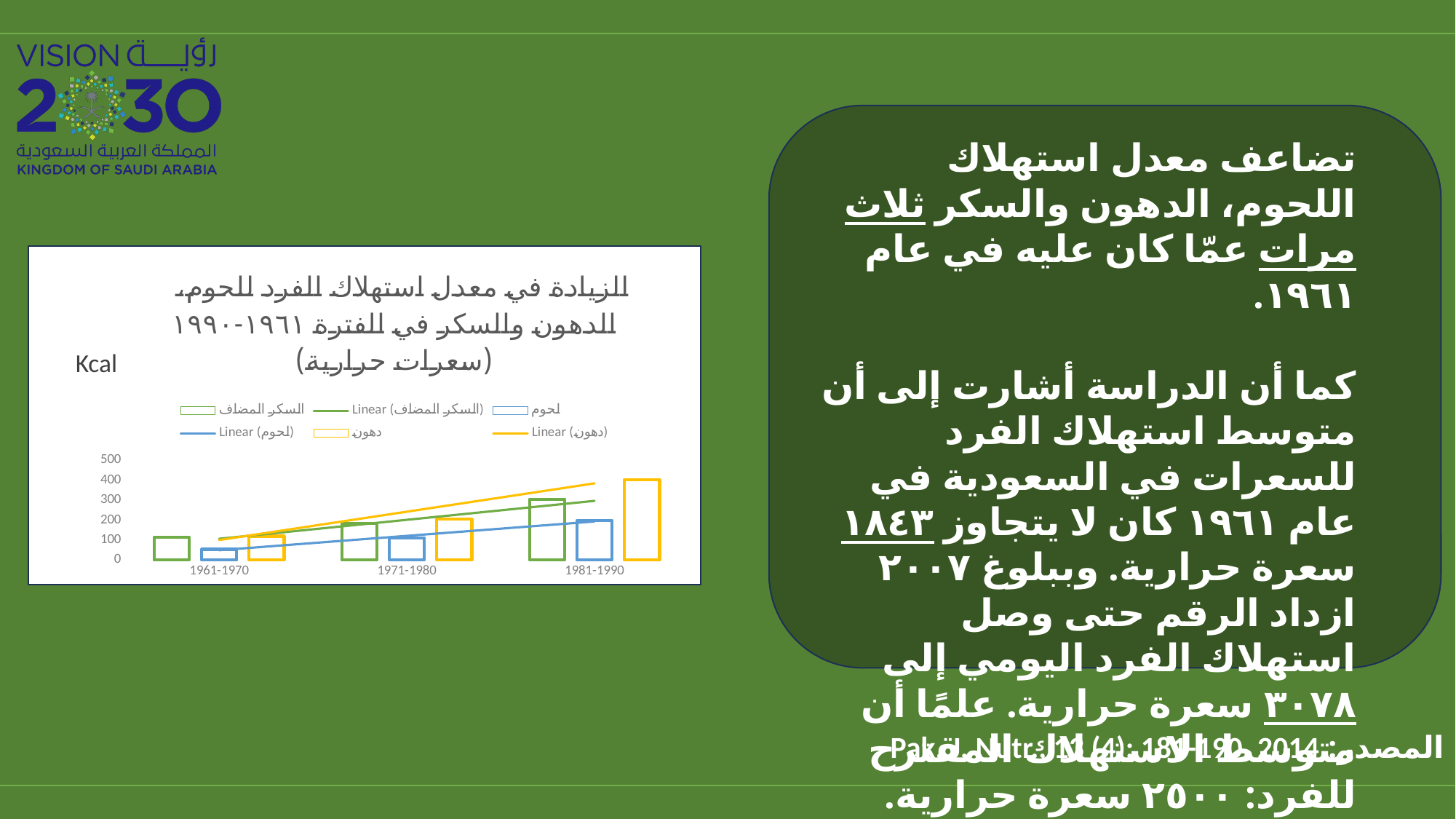
What kind of chart is shown on the slide? bar chart How many time periods are shown on the x axis of the chart? 3 What unit label is shown at the top of the chart's vertical axis? Kcal Is the value for السكر المضاف in 1981-1990 greater or less than 200? greater Is the value for دهون in 1971-1980 greater or less than 300? less In 1981-1990, which is larger: دهون or لحوم? دهون Do the values for دهون rise or fall from 1961-1970 to 1981-1990? rise How many entries does the chart's legend list? 6 In which period is the value for لحوم lowest? 1961-1970 Is the value for دهون in 1981-1990 greater or less than 300? greater In which period is the value for دهون highest? 1981-1990